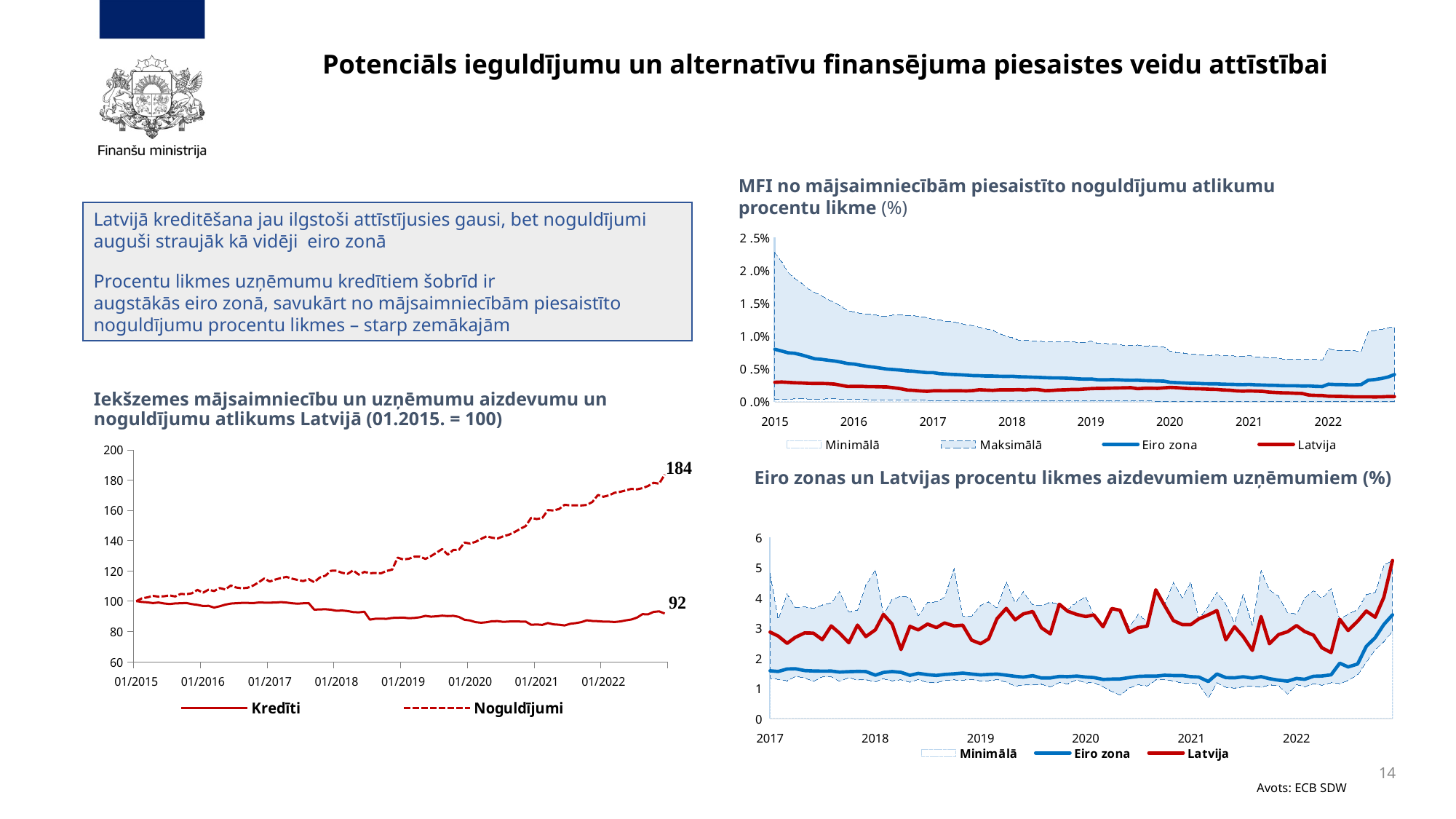
What kind of chart is 'Iekšzemes mājsaimniecību un uzņēmumu aizdevumu un noguldījumu atlikums Latvijā'? line chart On the chart 'Iekšzemes mājsaimniecību un uzņēmumu aizdevumu un noguldījumu atlikums Latvijā', which series ends higher, Kredīti or Noguldījumi? Noguldījumi On the chart 'MFI no mājsaimniecībām piesaistīto noguldījumu atlikumu procentu likme', how many entries does the legend list? 4 On the chart 'Eiro zonas un Latvijas procentu likmes aizdevumiem uzņēmumiem (%)', is the Eiro zona value at the start of 2017 greater or less than 2? less On the chart 'MFI no mājsaimniecībām piesaistīto noguldījumu atlikumu procentu likme', is the Eiro zona value at the start of 2015 greater or less than 0.5%? greater On the chart 'Iekšzemes mājsaimniecību un uzņēmumu aizdevumu un noguldījumu atlikums Latvijā', does the Noguldījumi series rise or fall over time? rise On the chart 'Iekšzemes mājsaimniecību un uzņēmumu aizdevumu un noguldījumu atlikums Latvijā', what is the difference between the final labelled values of Noguldījumi and Kredīti? 92 On the chart 'MFI no mājsaimniecībām piesaistīto noguldījumu atlikumu procentu likme', does the Eiro zona line rise or fall from 2015 to 2021? fall On the chart 'Iekšzemes mājsaimniecību un uzņēmumu aizdevumu un noguldījumu atlikums Latvijā', how many series does the legend list? 2 On the chart 'Iekšzemes mājsaimniecību un uzņēmumu aizdevumu un noguldījumu atlikums Latvijā', what is the final labelled value of the Kredīti series? 92 On the chart 'Eiro zonas un Latvijas procentu likmes aizdevumiem uzņēmumiem (%)', how many entries does the legend list? 3 On the chart 'Iekšzemes mājsaimniecību un uzņēmumu aizdevumu un noguldījumu atlikums Latvijā', what is the final labelled value of the Noguldījumi series? 184